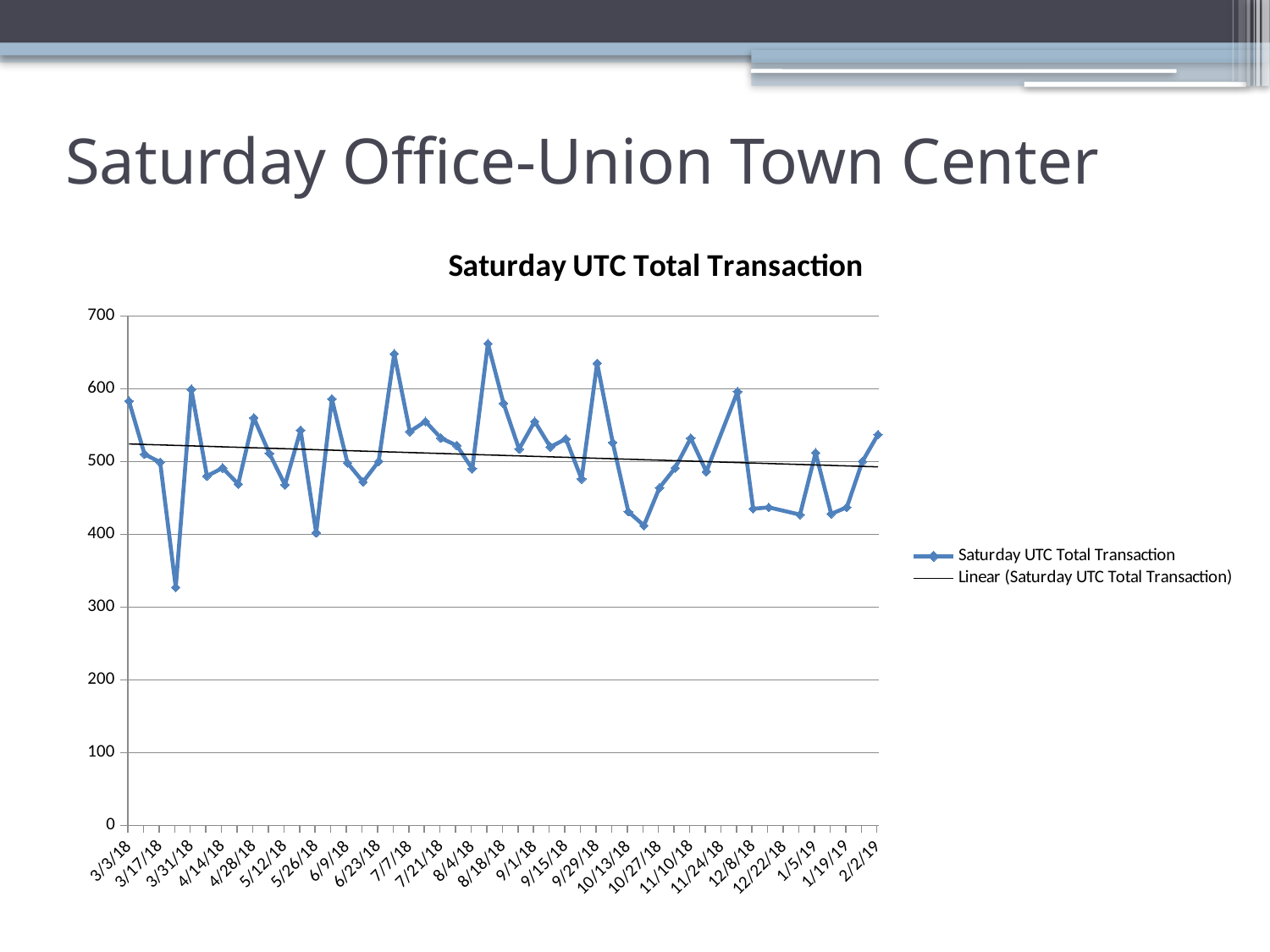
Which is larger, the value for 3/3/18 or the value for 10/27/18? 3/3/18 Is the value for 8/18/18 greater or less than 600? less Is the value for 7/7/18 greater or less than 600? less What kind of chart is shown on the slide? line chart According to the linear trendline, do the values rise or fall overall from 3/3/18 to 2/2/19? fall What is the second entry in the chart legend? Linear (Saturday UTC Total Transaction) Which is larger, the value for 8/18/18 or the value for 10/13/18? 8/18/18 How many entries does the chart legend list? 2 Is the value for 12/8/18 greater or less than 500? less What is the title of the chart? Saturday UTC Total Transaction